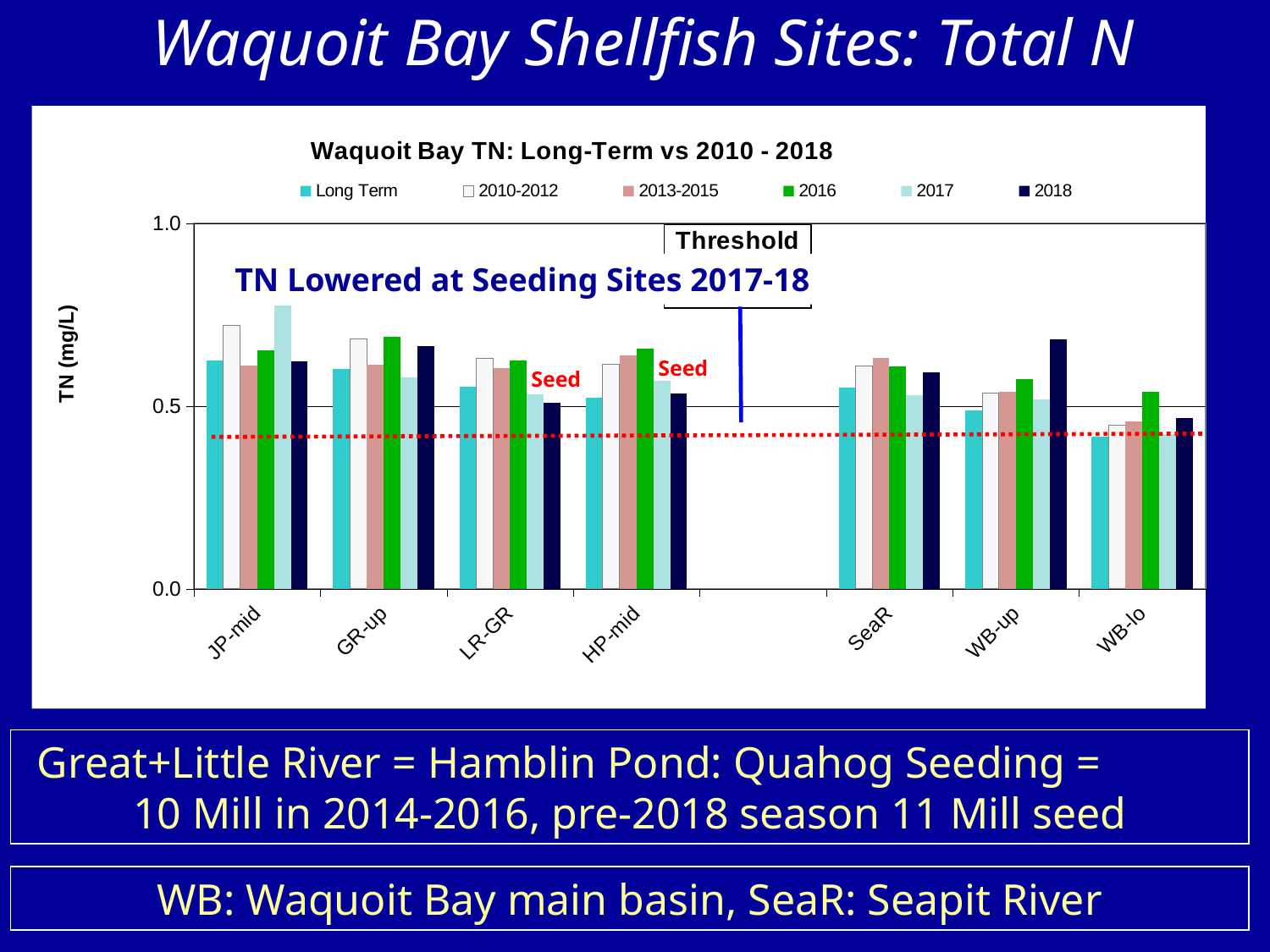
Is the 2016 value for GR-up greater or less than 0.5? greater Which is larger: the 2017 value for JP-mid or the Long Term value for WB-lo? 2017 value for JP-mid How many site categories are shown along the x axis? 7 Is the Long Term value for WB-lo greater or less than 0.5? less Which series has the highest value at WB-up? 2018 What is the title of the chart? Waquoit Bay TN: Long-Term vs 2010 - 2018 Is the 2018 value for WB-up greater or less than 0.5? greater Which series has the highest value at JP-mid? 2017 What kind of chart is shown on the slide? bar chart How many series does the chart legend list? 6 What is the label of the y axis? TN (mg/L)